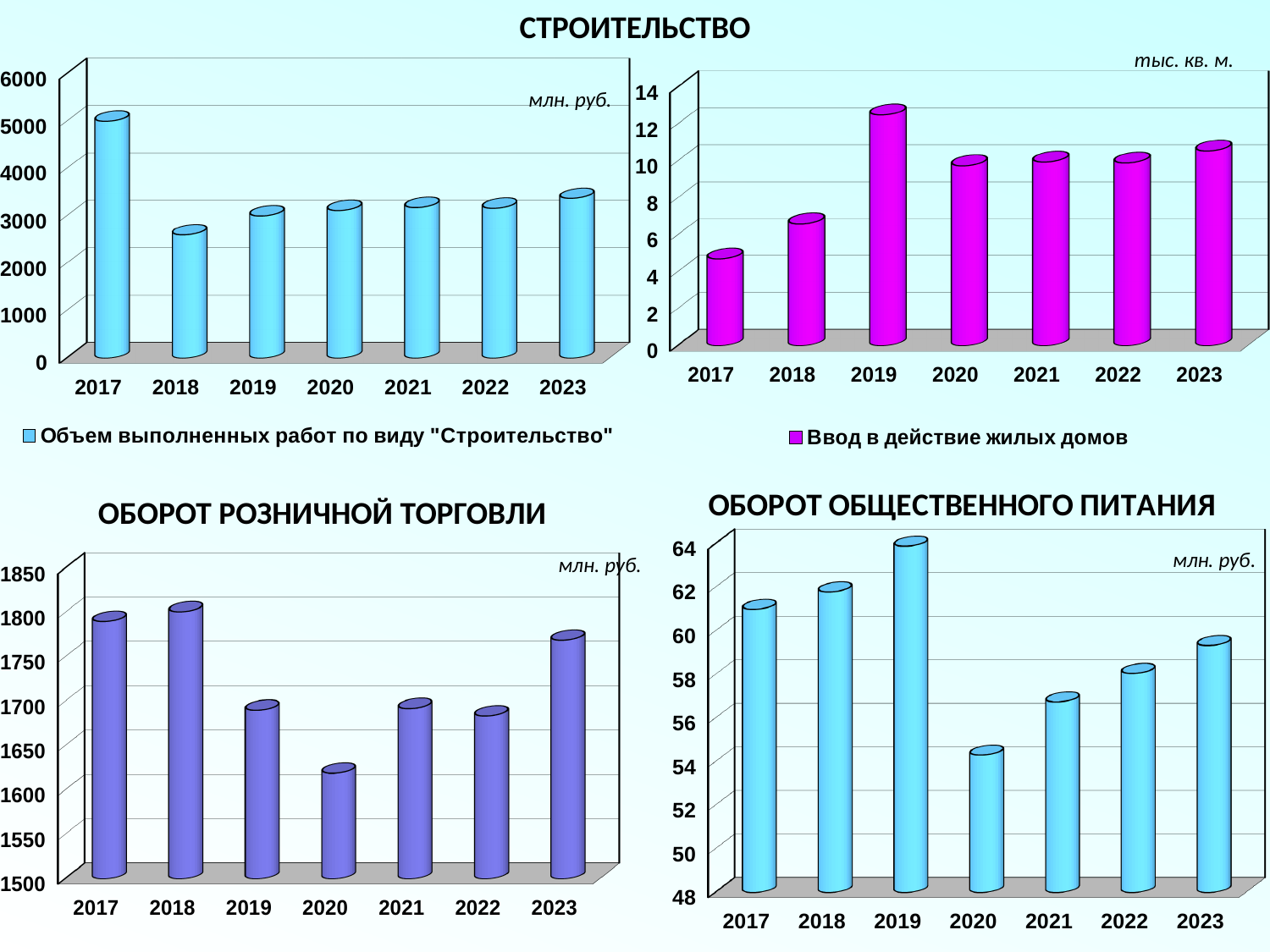
In the chart titled ОБОРОТ РОЗНИЧНОЙ ТОРГОВЛИ, is the value for 2023 greater or less than 1750? greater How many years are shown on the x axis of the chart titled ОБОРОТ ОБЩЕСТВЕННОГО ПИТАНИЯ? 7 In the top-left chart (Объем выполненных работ по виду "Строительство"), which year has the lowest value? 2018 In the chart titled ОБОРОТ ОБЩЕСТВЕННОГО ПИТАНИЯ, which year has the highest value? 2019 In the top-right chart (Ввод в действие жилых домов), which year has the highest value? 2019 In the top-right chart (Ввод в действие жилых домов), which is larger, the value for 2018 or the value for 2020? 2020 In the top-right chart (Ввод в действие жилых домов), is the value for 2018 greater or less than 8? less In the top-right chart (Ввод в действие жилых домов), which year has the lowest value? 2017 In the top-left chart (Объем выполненных работ по виду "Строительство"), is the value for 2017 greater or less than 4000? greater In the chart titled ОБОРОТ ОБЩЕСТВЕННОГО ПИТАНИЯ, which year has the lowest value? 2020 In the top-left chart (Объем выполненных работ по виду "Строительство"), which year has the highest value? 2017